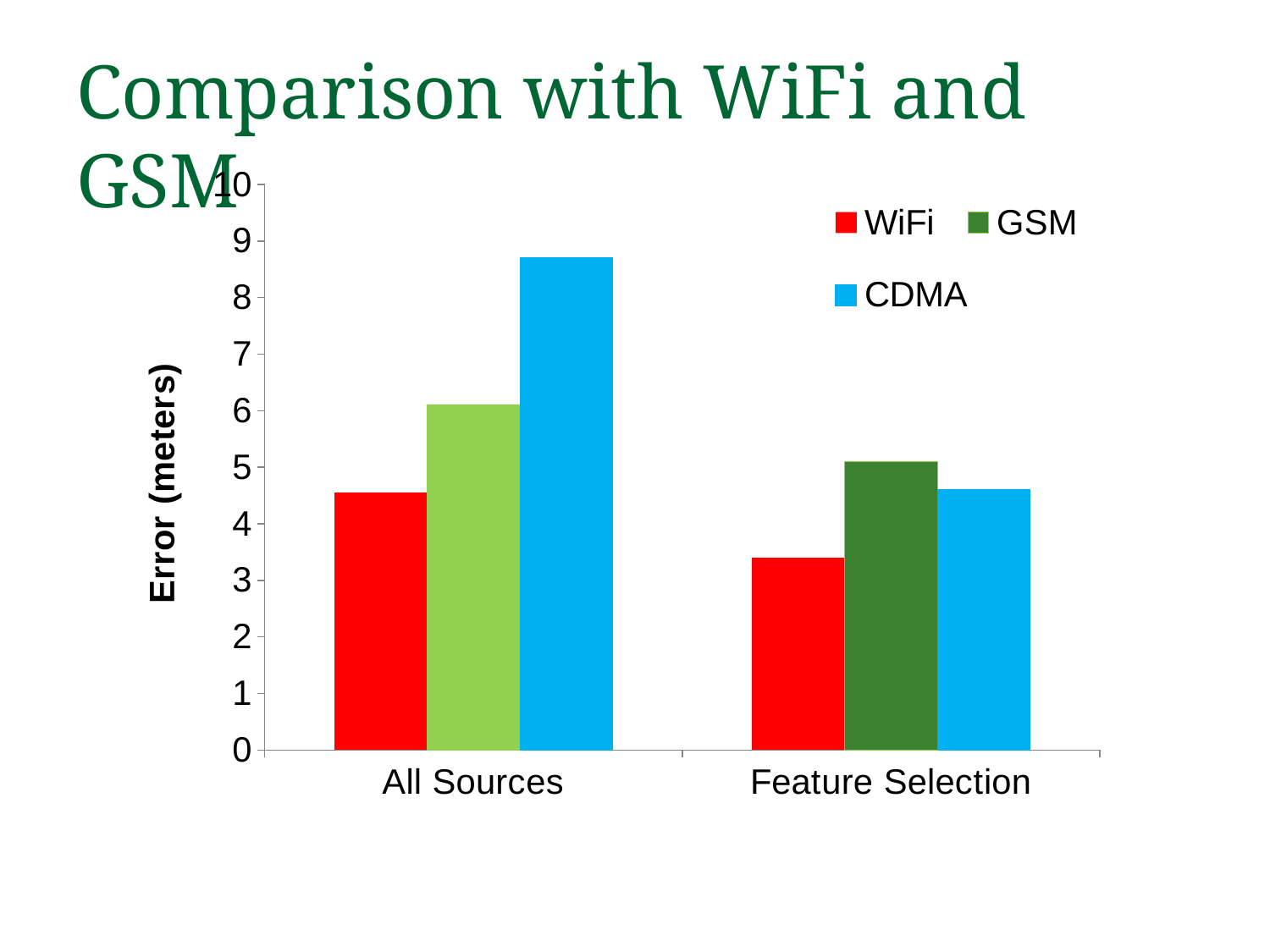
Which series has the lowest error for Feature Selection? WiFi Is the GSM error for All Sources greater or less than 7? less Is the CDMA error for All Sources greater or less than 8? greater How many series does the legend list? 3 Which series has the highest error for Feature Selection? GSM What kind of chart is shown on the slide? bar chart Which series has the highest error for All Sources? CDMA Which is larger, the CDMA error for All Sources or the CDMA error for Feature Selection? All Sources Which series has the lowest error for All Sources? WiFi Is the WiFi error for Feature Selection greater or less than 4? less How many categories are shown on the x axis? 2 What is the label of the vertical axis? Error (meters)